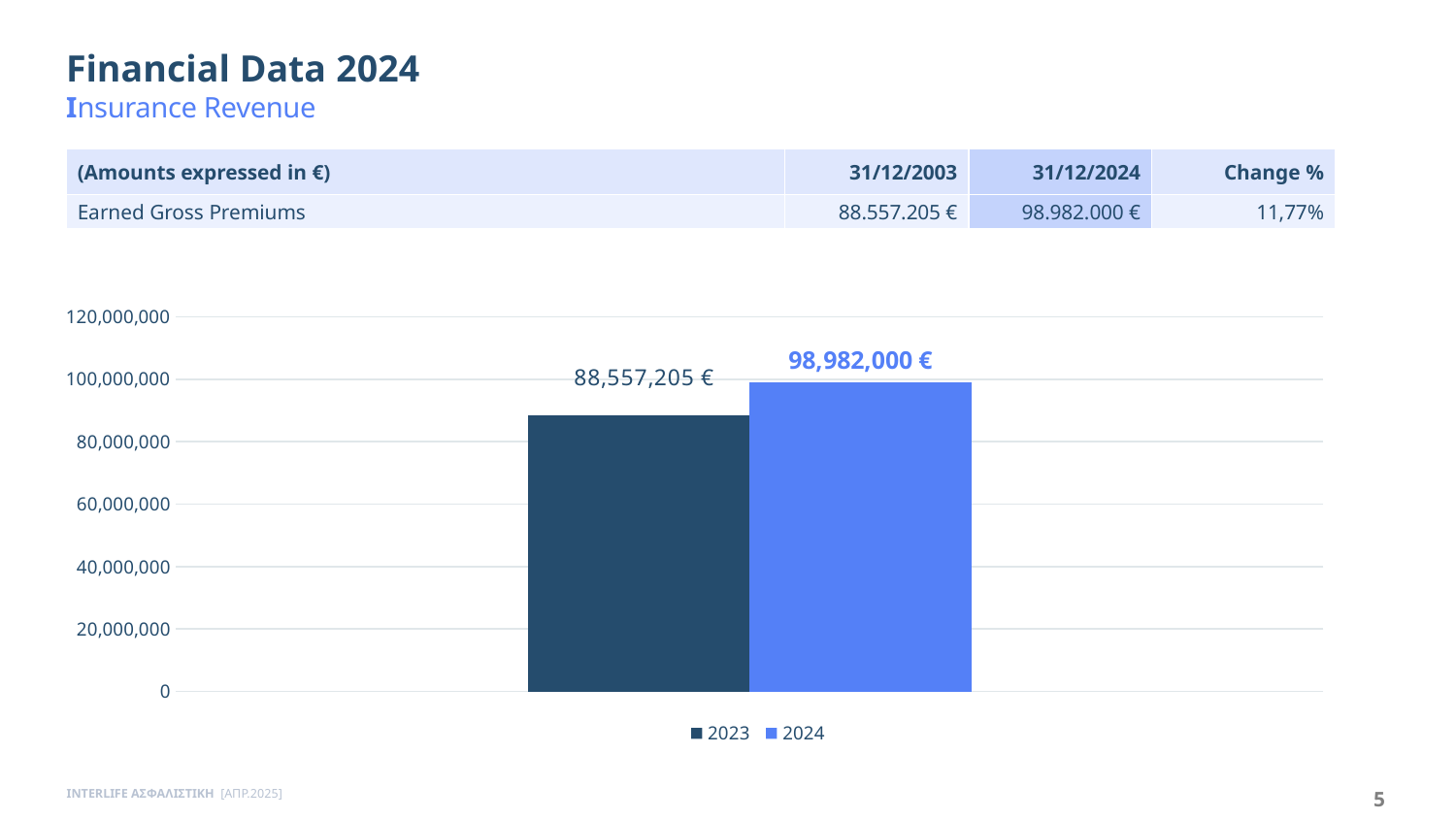
Is the value for 2023 greater or less than 100,000,000? less What is the value shown for 2024 in the chart? 98,982,000 € What is the difference between the 2024 value and the 2023 value in the chart? 10,424,795 € Which series has the lowest value in the chart? 2023 What is the value shown for 2023 in the chart? 88,557,205 € Which series has the highest value in the chart? 2024 What is the highest value labelled on the chart's vertical axis? 120,000,000 Do the values rise or fall from 2023 to 2024 in the chart? Rise How many series does the chart legend list? 2 What kind of chart is shown on the slide? Bar chart Is the value for 2024 greater or less than 80,000,000? greater Which series has the higher value in the chart, 2023 or 2024? 2024